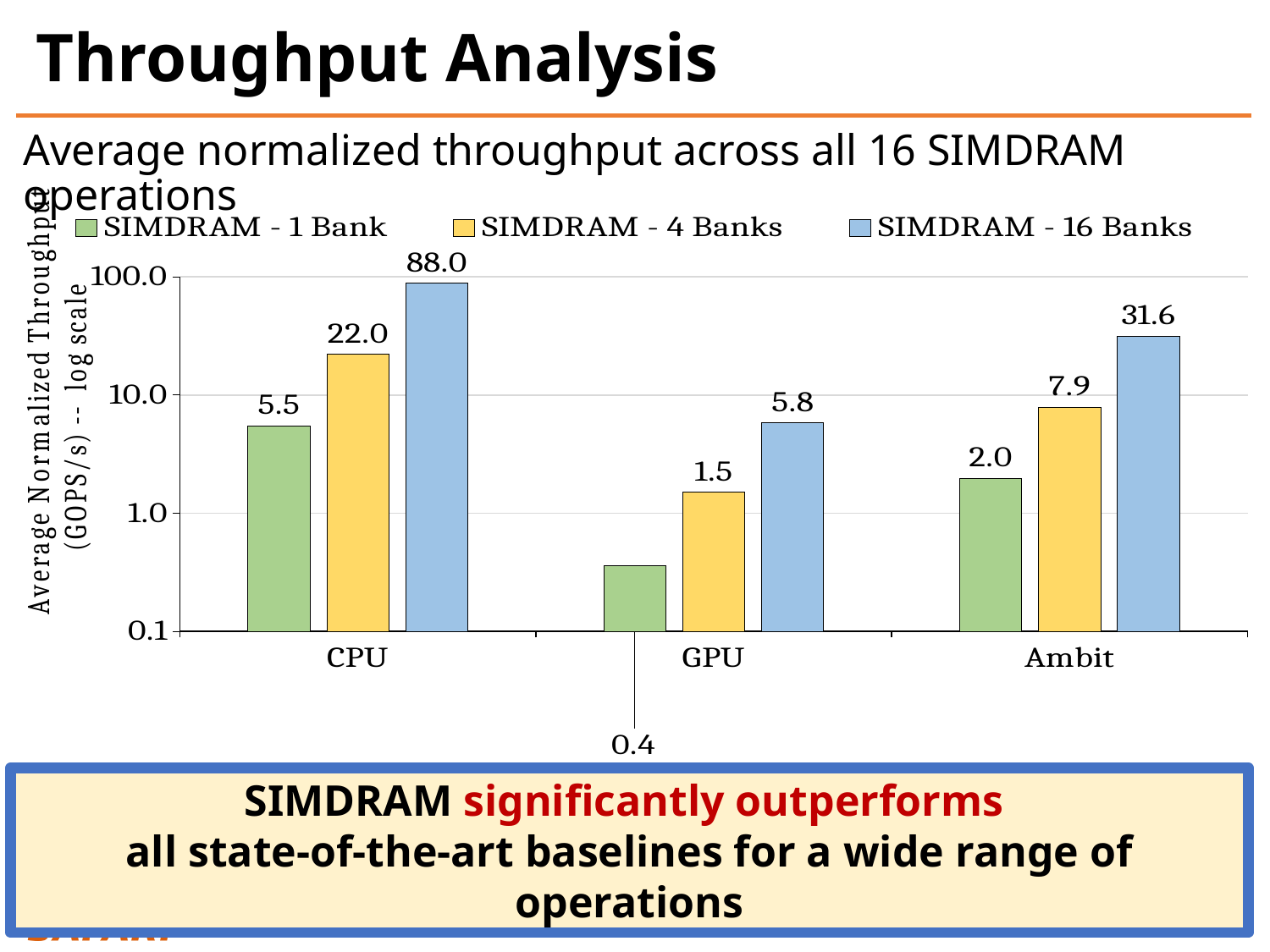
What is the y-axis label of the chart? Average Normalized Throughput (GOPS/s) -- log scale What kind of chart is shown on the slide? Bar chart What is the difference between the SIMDRAM - 16 Banks value on CPU and on Ambit? 56.4 How many series does the legend list? 3 Which baseline has the highest value for SIMDRAM - 16 Banks? CPU What is the value for SIMDRAM - 1 Bank on GPU? 0.4 What is the value for SIMDRAM - 1 Bank on Ambit? 2.0 What is the value for SIMDRAM - 16 Banks on CPU? 88.0 Which is larger: the SIMDRAM - 4 Banks value on Ambit or the SIMDRAM - 16 Banks value on GPU? SIMDRAM - 4 Banks on Ambit How many baseline categories are shown on the x axis? 3 Which baseline has the lowest value for SIMDRAM - 4 Banks? GPU What is the value for SIMDRAM - 4 Banks on GPU? 1.5